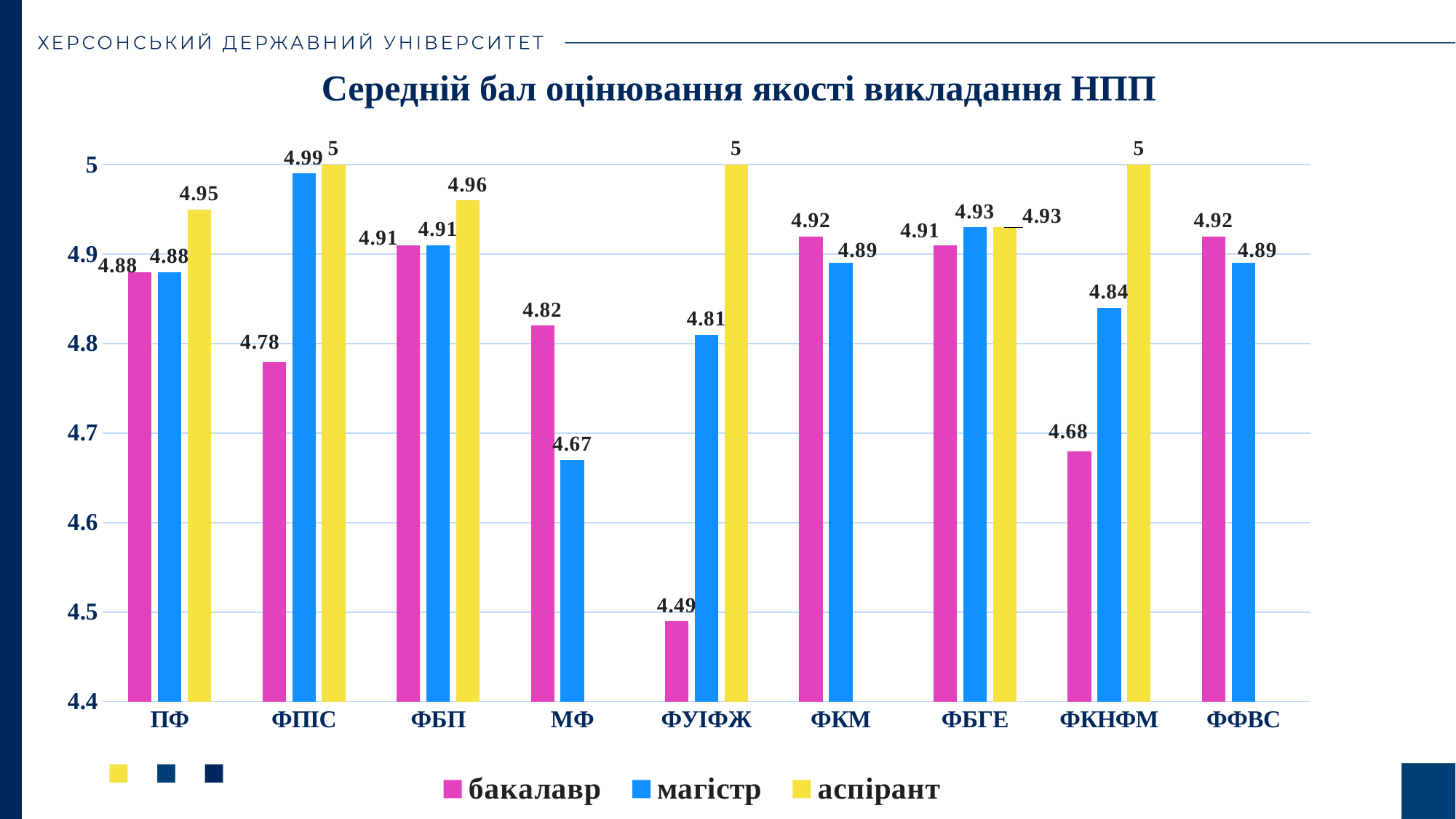
What type of chart is shown on the slide? bar chart What is the difference between the аспірант and бакалавр values at ФУІФЖ? 0.51 What is the value for бакалавр at ФУІФЖ? 4.49 What is the value for аспірант at ФБП? 4.96 What is the value for магістр at ФПІС? 4.99 Which category has the highest value for магістр? ФПІС Which is larger at ФКНФМ, the value for бакалавр or for магістр? магістр How many categories are shown on the x axis? 9 Which category has the lowest value for бакалавр? ФУІФЖ What is the title of the chart? Середній бал оцінювання якості викладання НПП How many series does the legend list? 3 Which category has the lowest value for магістр? МФ